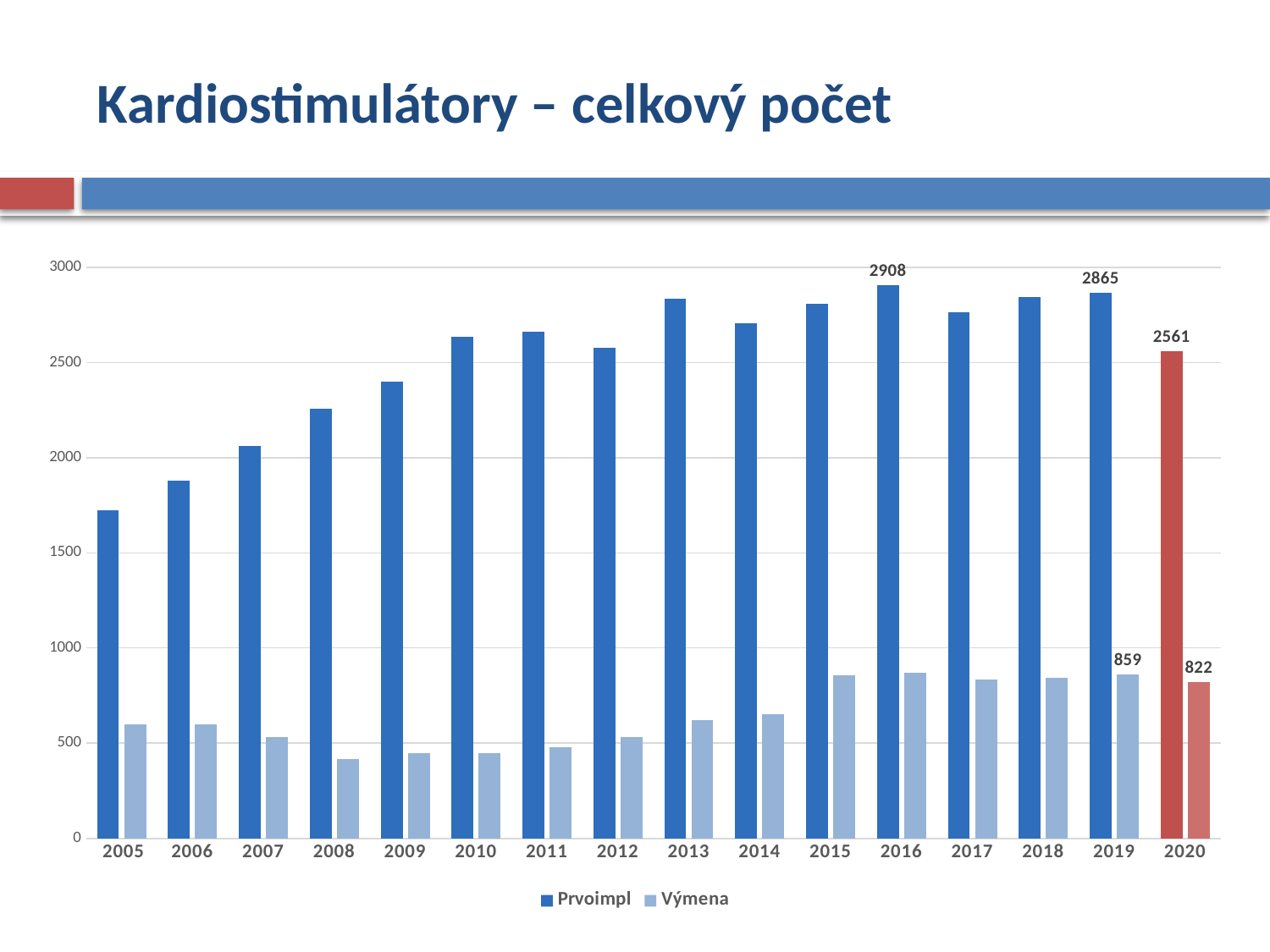
What is the Prvoimpl value for 2016? 2908 What is the Výmena value for 2020? 822 In which year is the Prvoimpl value lowest? 2005 What is the difference between the Výmena values for 2019 and 2020? 37 By how much did the Prvoimpl value fall from 2019 to 2020? 304 In which year is the Prvoimpl value highest? 2016 Is the Prvoimpl value for 2005 greater or less than 2000? less Is the Prvoimpl value for 2010 greater or less than 2500? greater How many series does the legend list? 2 What is the Prvoimpl value for 2020? 2561 What is the Výmena value for 2019? 859 How many years are shown on the x axis? 16